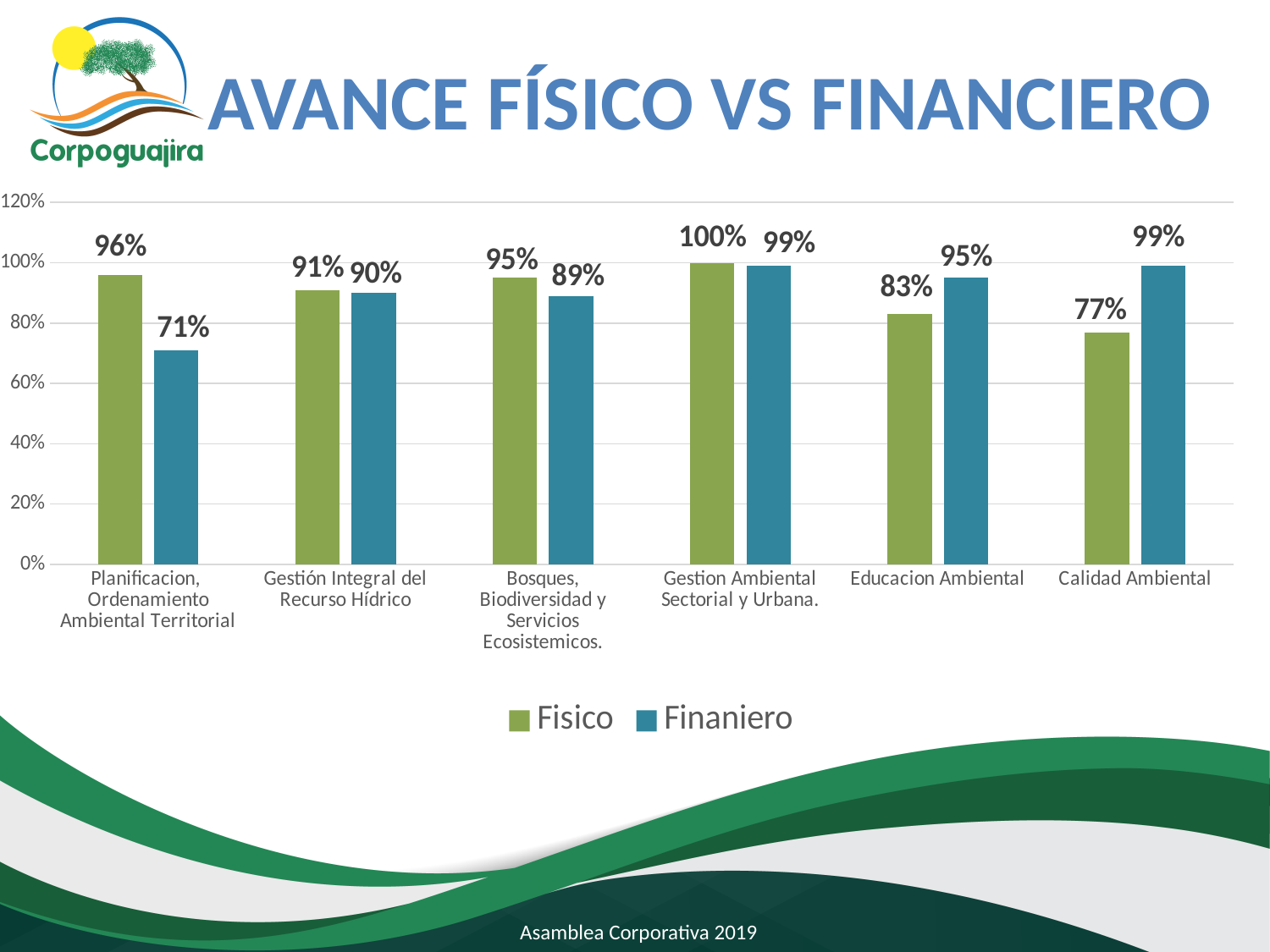
How many series does the legend list? 2 What is the Fisico value for Planificacion, Ordenamiento Ambiental Territorial? 96% What is the Fisico value for Calidad Ambiental? 77% Which category has the lowest Finaniero value? Planificacion, Ordenamiento Ambiental Territorial What is the Finaniero value for Educacion Ambiental? 95% Which is larger for Calidad Ambiental, the Fisico value or the Finaniero value? Finaniero What is the difference between the Fisico and Finaniero values for Planificacion, Ordenamiento Ambiental Territorial? 25% Which category has the highest Fisico value? Gestion Ambiental Sectorial y Urbana. What kind of chart is shown on the slide? Bar chart How many categories are shown on the x axis? 6 What is the difference between the Fisico and Finaniero values for Bosques, Biodiversidad y Servicios Ecosistemicos.? 6% What is the title of the chart? AVANCE FÍSICO VS FINANCIERO